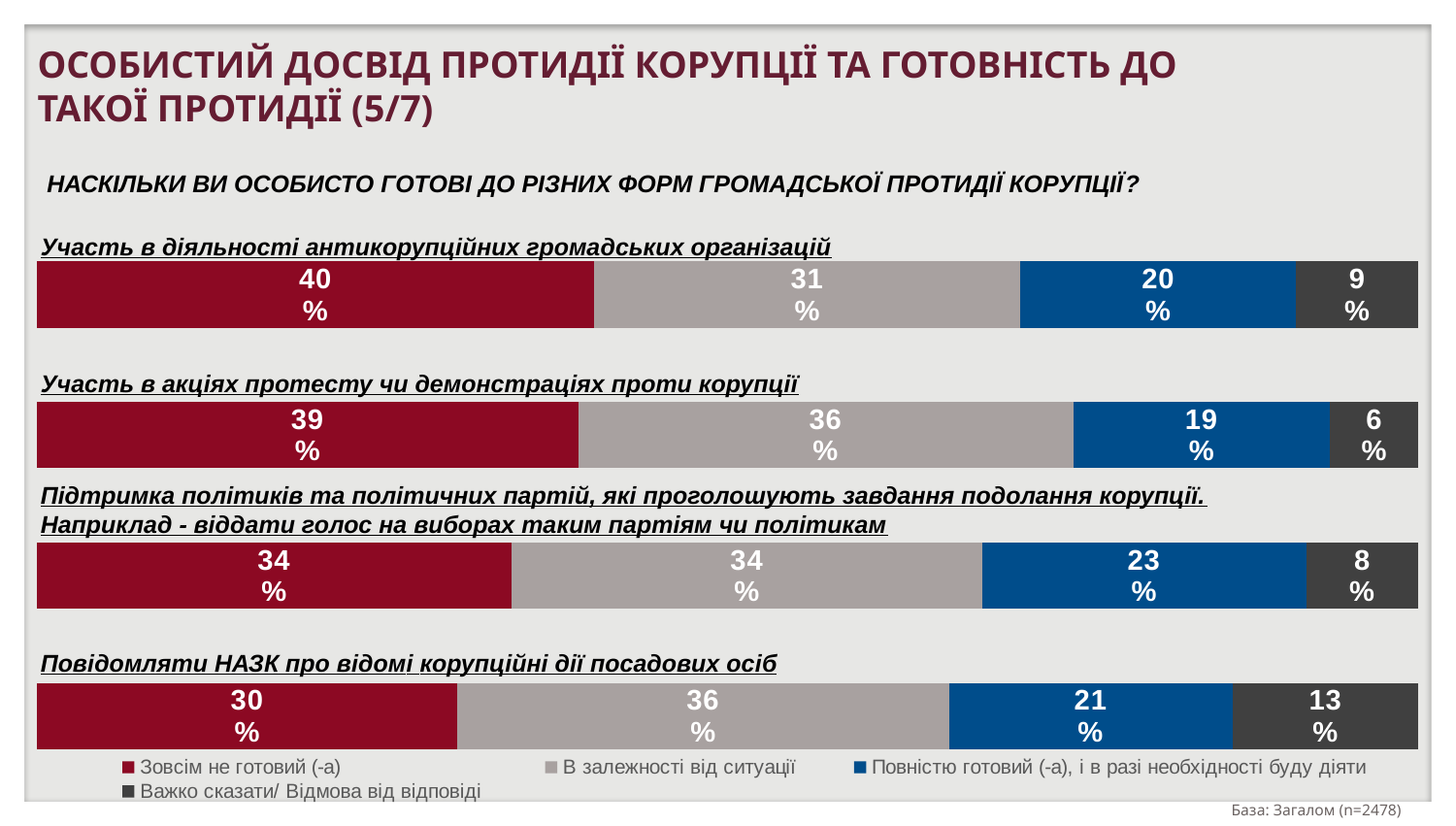
In the chart 'Повідомляти НАЗК про відомі корупційні дії посадових осіб', which response has the highest share? В залежності від ситуації What kind of chart is used on this slide? Stacked bar chart In the chart 'Повідомляти НАЗК про відомі корупційні дії посадових осіб', what is the value for 'Важко сказати/ Відмова від відповіді'? 13% In the chart 'Підтримка політиків та політичних партій...', what is the value for 'Повністю готовий (-а), і в разі необхідності буду діяти'? 23% In the chart 'Підтримка політиків та політичних партій...', what is the total of the stacked bar? 99% In the chart 'Участь в акціях протесту чи демонстраціях проти корупції', what is the difference between 'Зовсім не готовий (-а)' and 'Повністю готовий (-а), і в разі необхідності буду діяти'? 20% In the chart 'Участь в акціях протесту чи демонстраціях проти корупції', what is the value for 'В залежності від ситуації'? 36% In the chart 'Участь в діяльності антикорупційних громадських організацій', what is the value for 'Зовсім не готовий (-а)'? 40% Which colour represents 'Повністю готовий (-а), і в разі необхідності буду діяти' in the legend? Blue In the chart 'Повідомляти НАЗК про відомі корупційні дії посадових осіб', which is larger: 'Зовсім не готовий (-а)' or 'В залежності від ситуації'? В залежності від ситуації In the chart 'Участь в діяльності антикорупційних громадських організацій', which response has the lowest share? Важко сказати/ Відмова від відповіді How many series does the legend list? 4